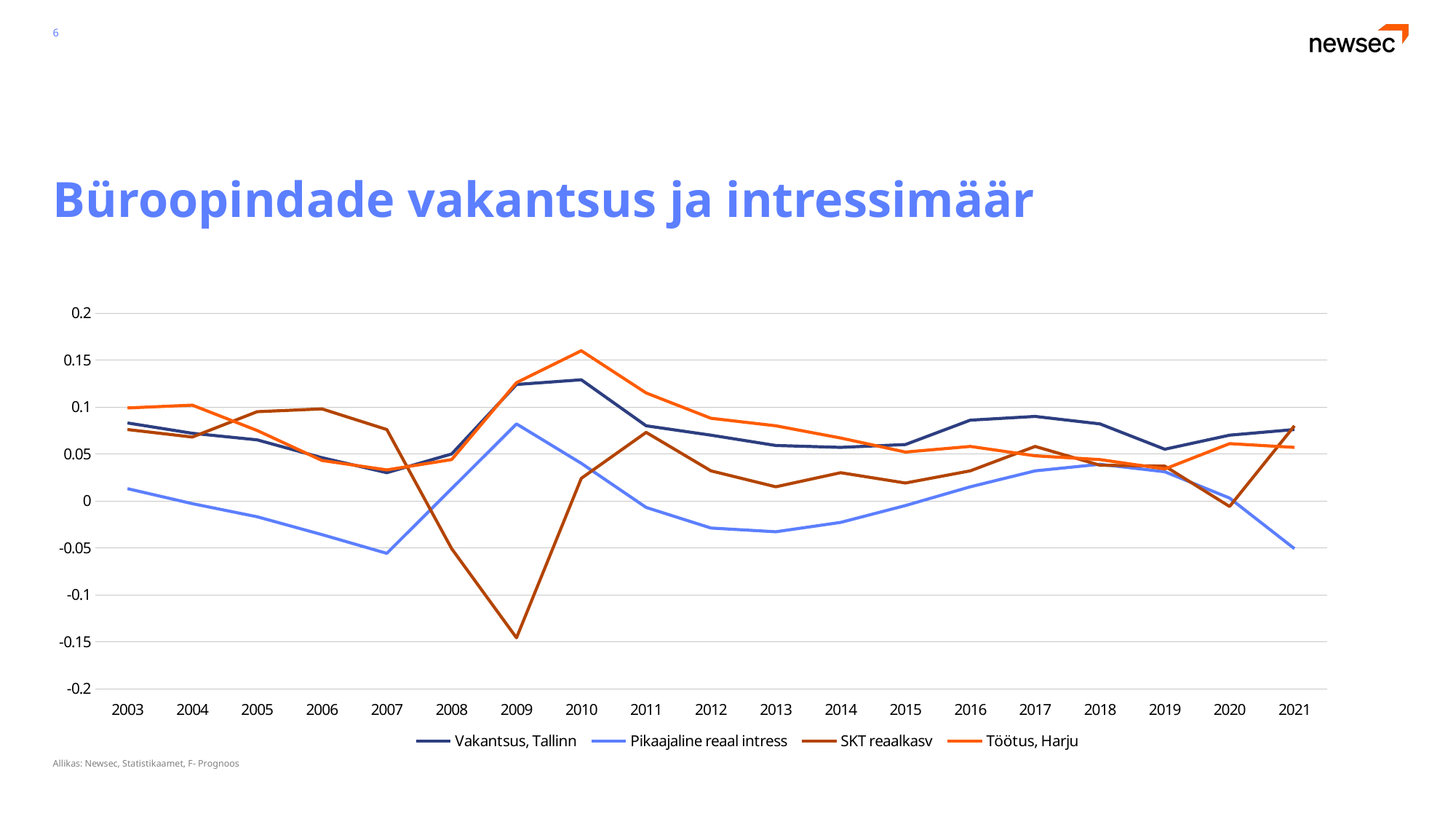
In which year does the SKT reaalkasv series reach its lowest value? 2009 Is the value for Vakantsus, Tallinn in 2010 greater or less than 0.1? greater How many years are plotted along the x axis? 19 How many series does the legend list? 4 In which year does the Pikaajaline reaal intress series reach its highest value? 2009 Does the Töötus, Harju series rise or fall from 2010 to 2015? fall In 2021, which is larger: Pikaajaline reaal intress or SKT reaalkasv? SKT reaalkasv What kind of chart is shown on the slide? line chart Is the value for SKT reaalkasv in 2009 greater or less than -0.1? less Is the value for Töötus, Harju in 2010 greater or less than 0.15? greater In which year does the Töötus, Harju series reach its highest value? 2010 In 2009, which is larger: Vakantsus, Tallinn or Pikaajaline reaal intress? Vakantsus, Tallinn